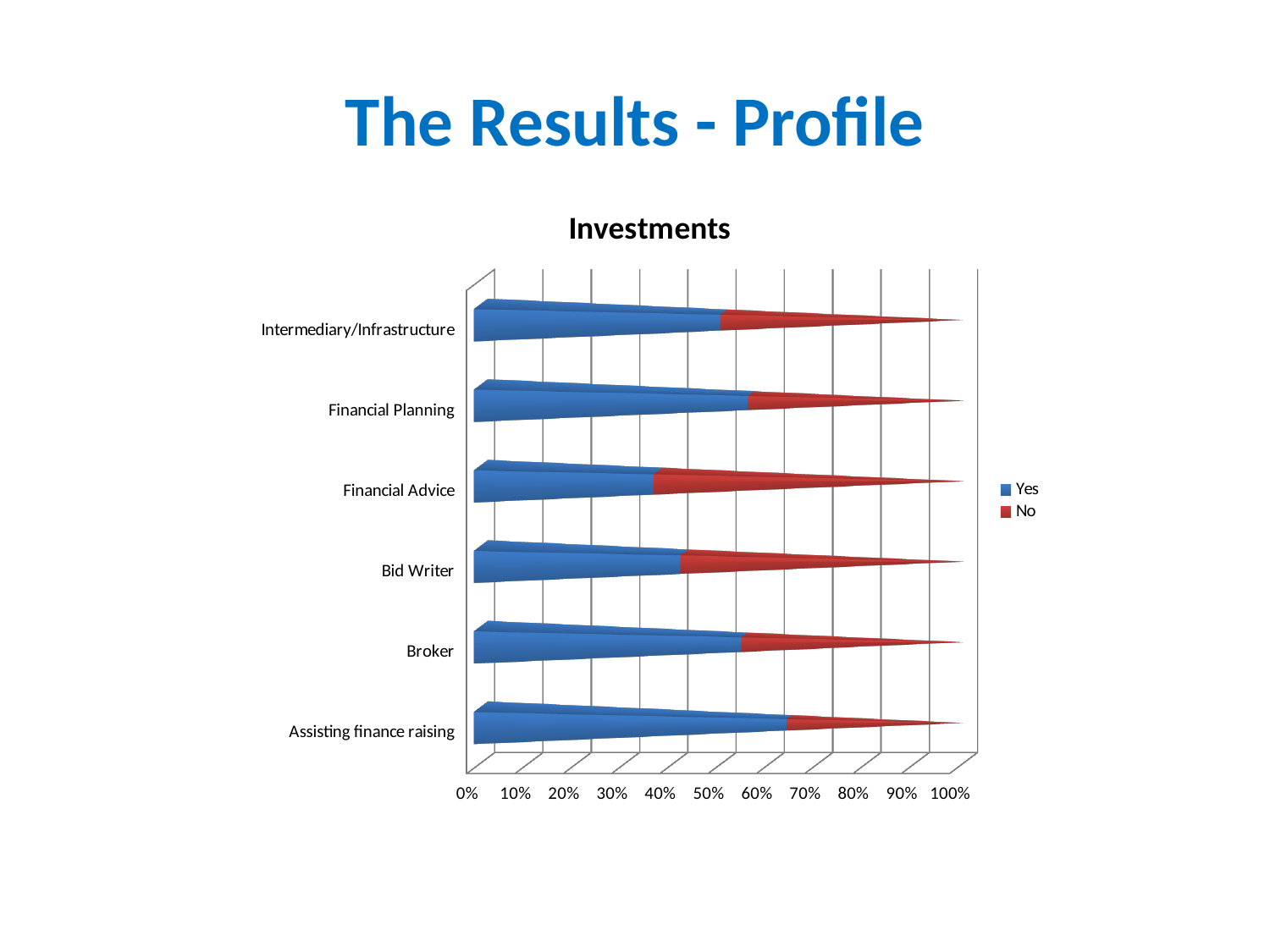
Which category has the highest "Yes" share? Assisting finance raising Is the "Yes" value for Assisting finance raising greater or less than 60%? greater What kind of chart is shown on the slide? bar chart How many categories are shown on the chart? 6 Which category has the largest "No" share? Financial Advice Which has the larger "Yes" share, Broker or Financial Advice? Broker Which category has the lowest "Yes" share? Financial Advice Which colour represents the "No" series? red How many series does the legend list? 2 What is the title of the chart? Investments Is the "Yes" value for Bid Writer greater or less than 50%? less Is the "Yes" value for Financial Planning greater or less than 50%? greater